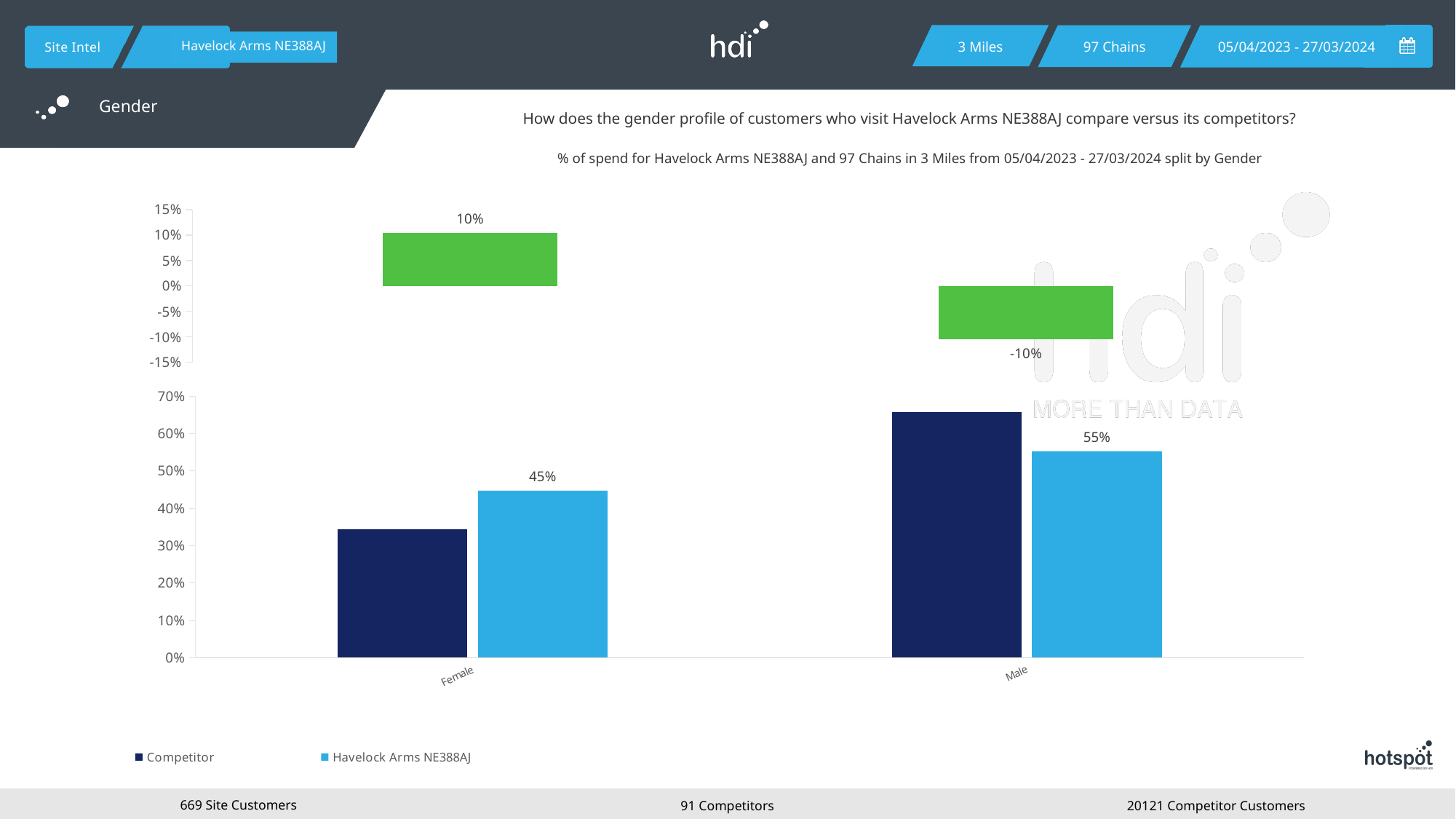
In the bottom bar chart, what is the difference between the Havelock Arms NE388AJ values for Male and Female? 10% In the bottom bar chart, which category has the higher value for Havelock Arms NE388AJ, Female or Male? Male In the bottom bar chart, is the Competitor value for Male greater or less than 60%? greater In the bottom bar chart, what is the value for Havelock Arms NE388AJ in the Male category? 55% In the bottom bar chart, is the Competitor value for Female greater or less than 40%? less In the top chart with green bars, what is the value shown for Male? -10% In the bottom bar chart, what is the value for Havelock Arms NE388AJ in the Female category? 45% In the bottom bar chart, in the Male category, which series has the larger value, Competitor or Havelock Arms NE388AJ? Competitor What type of chart is the bottom chart on the slide? Bar chart In the bottom bar chart, in the Female category, which series has the larger value, Competitor or Havelock Arms NE388AJ? Havelock Arms NE388AJ In the top chart with green bars, what is the value shown for Female? 10% How many series does the legend of the bottom bar chart list? 2